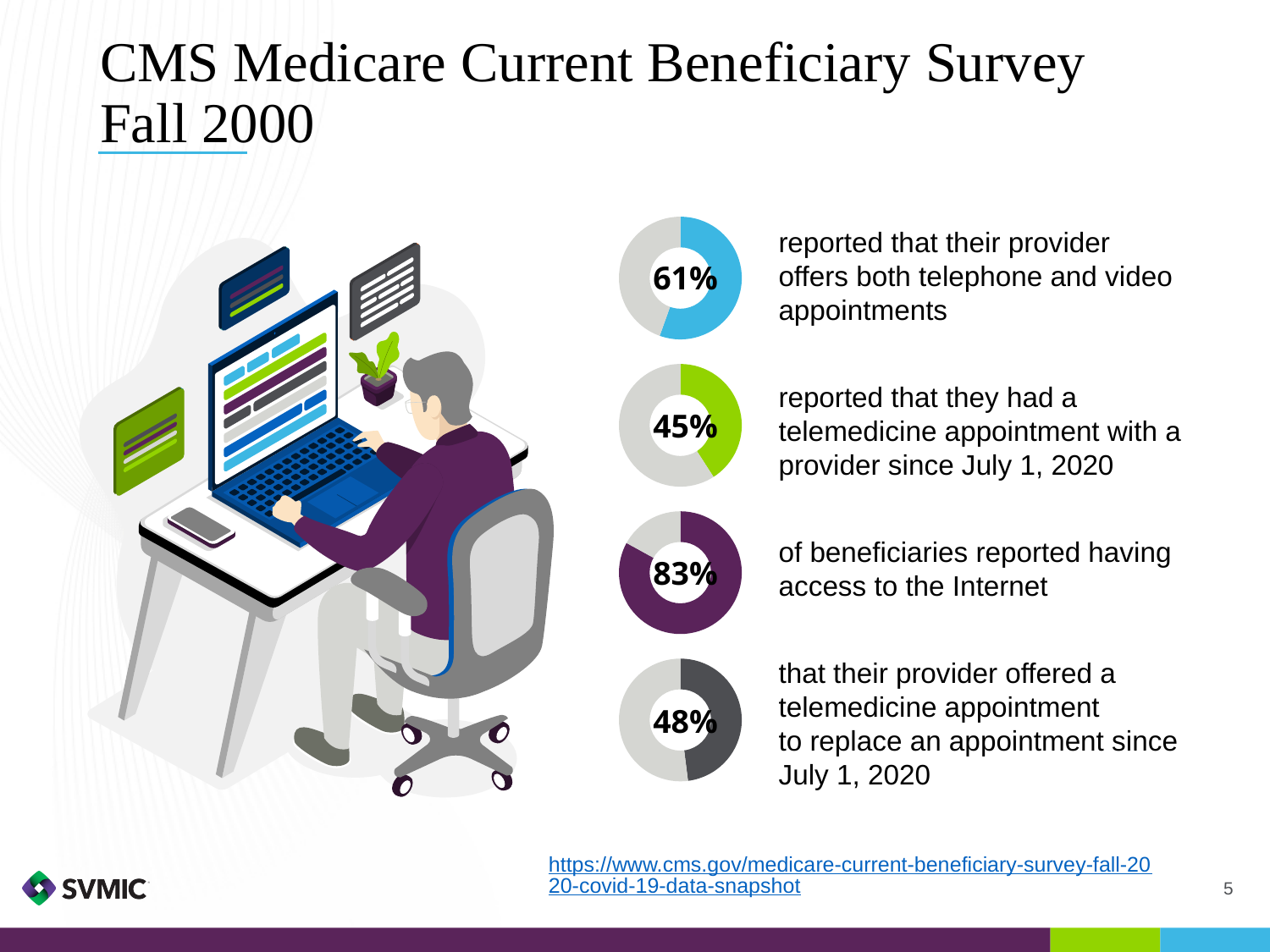
Which of the four donut charts shows the highest percentage? 83% (access to the Internet) What percentage is shown in the third donut chart, for beneficiaries who reported having access to the Internet? 83% What is the difference between the percentage reporting Internet access and the percentage whose provider offers both telephone and video appointments? 22 percentage points What percentage is shown in the second donut chart, for beneficiaries who had a telemedicine appointment with a provider since July 1, 2020? 45% What percentage is shown in the top donut chart, for beneficiaries whose provider offers both telephone and video appointments? 61% Which of the four donut charts shows the lowest percentage? 45% (had a telemedicine appointment since July 1, 2020) What type of chart is used to display the percentages on the slide? Donut chart How many donut charts are shown on the slide? 4 What percentage is shown in the bottom donut chart, for beneficiaries whose provider offered a telemedicine appointment to replace an appointment since July 1, 2020? 48% Which is larger: the percentage whose provider offered a telemedicine appointment to replace an appointment, or the percentage who had a telemedicine appointment since July 1, 2020? Provider offered a telemedicine appointment to replace an appointment (48%) What colour is the filled portion of the donut chart showing 83%? Purple What colour is the filled portion of the donut chart showing 45%? Green